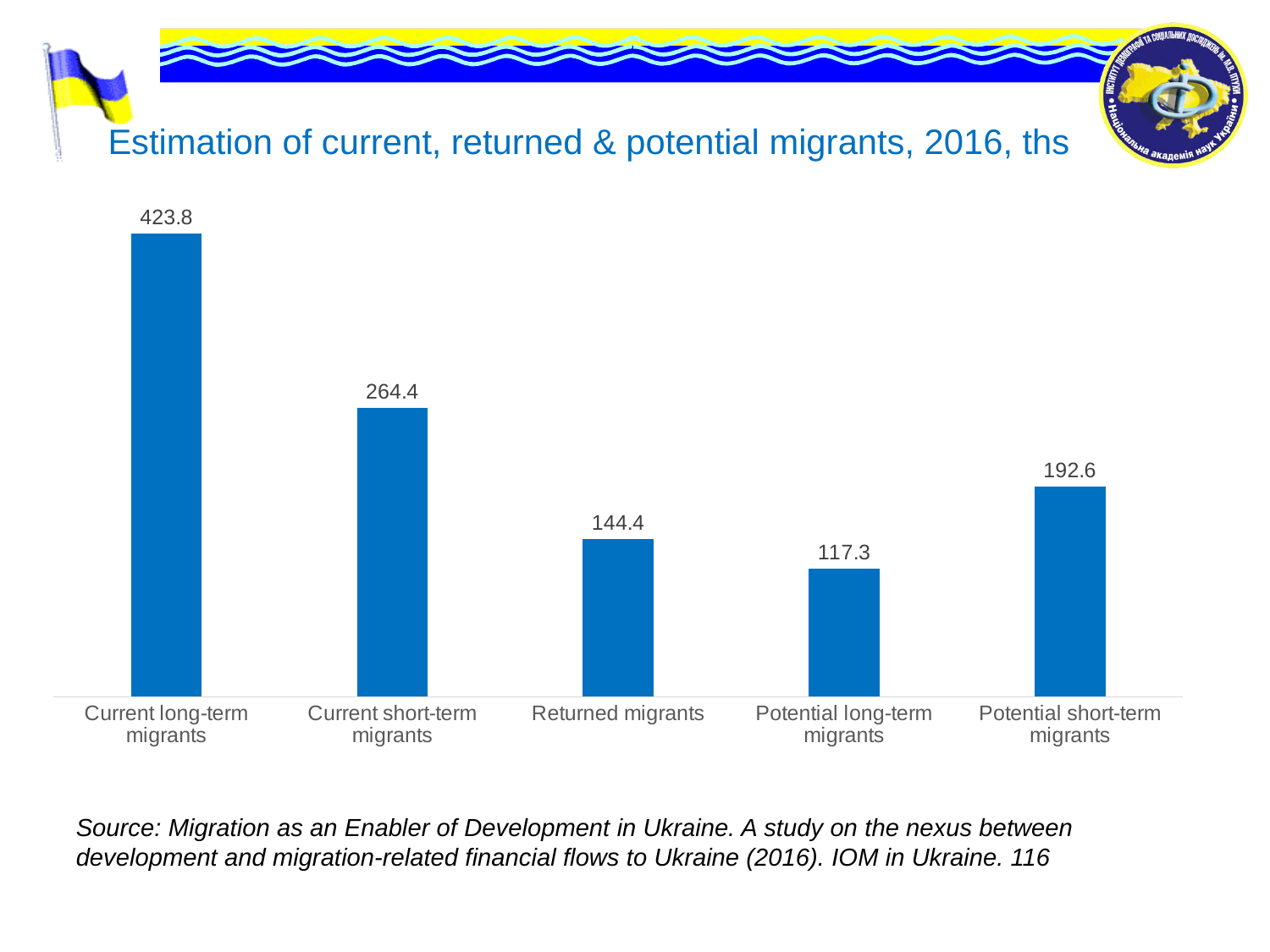
What is the value for Current short-term migrants? 264.4 What is the difference between Current long-term migrants and Current short-term migrants? 159.4 Which is larger, Returned migrants or Potential short-term migrants? Potential short-term migrants What is the difference between Potential short-term migrants and Potential long-term migrants? 75.3 What is the value for Potential long-term migrants? 117.3 What kind of chart is shown on the slide? Bar chart What is the value for Current long-term migrants? 423.8 What is the value for Returned migrants? 144.4 How many categories are shown in the chart? 5 Which category has the highest value? Current long-term migrants What is the value for Potential short-term migrants? 192.6 Which category has the lowest value? Potential long-term migrants